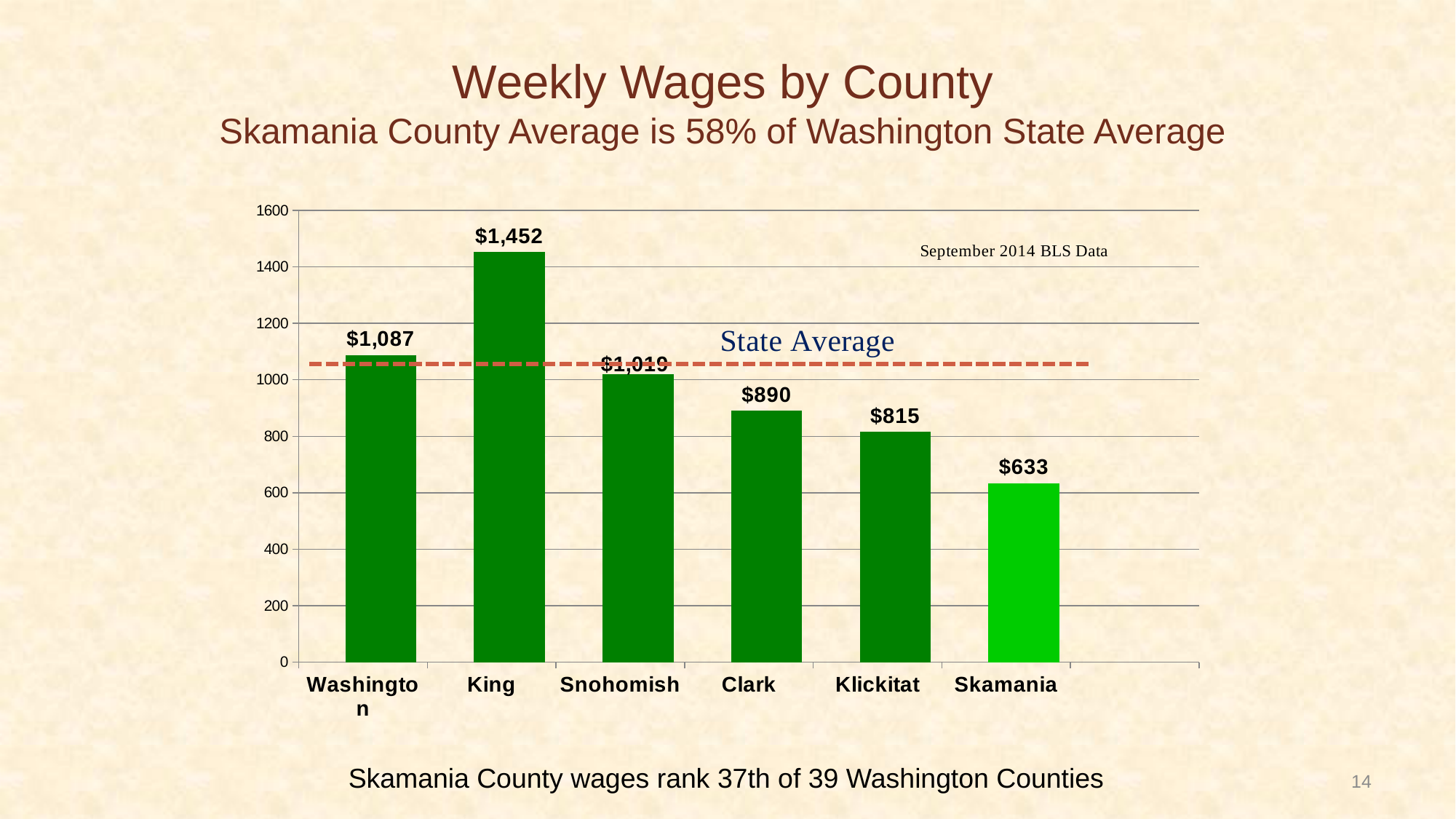
What is the difference between the King County wage and the Skamania County wage? $819 What is the weekly wage shown for Clark County? $890 What is the weekly wage shown for King County? $1,452 Is the value for Skamania greater or less than 800? less How many categories are shown on the x axis? 6 Which is larger, the weekly wage for Washington or for Clark? Washington What is the difference between the Clark County wage and the Klickitat County wage? $75 Which category has the lowest weekly wage? Skamania What is the weekly wage shown for Klickitat County? $815 What is the weekly wage shown for Skamania County? $633 Which category has the highest weekly wage? King What kind of chart is shown on the slide? bar chart